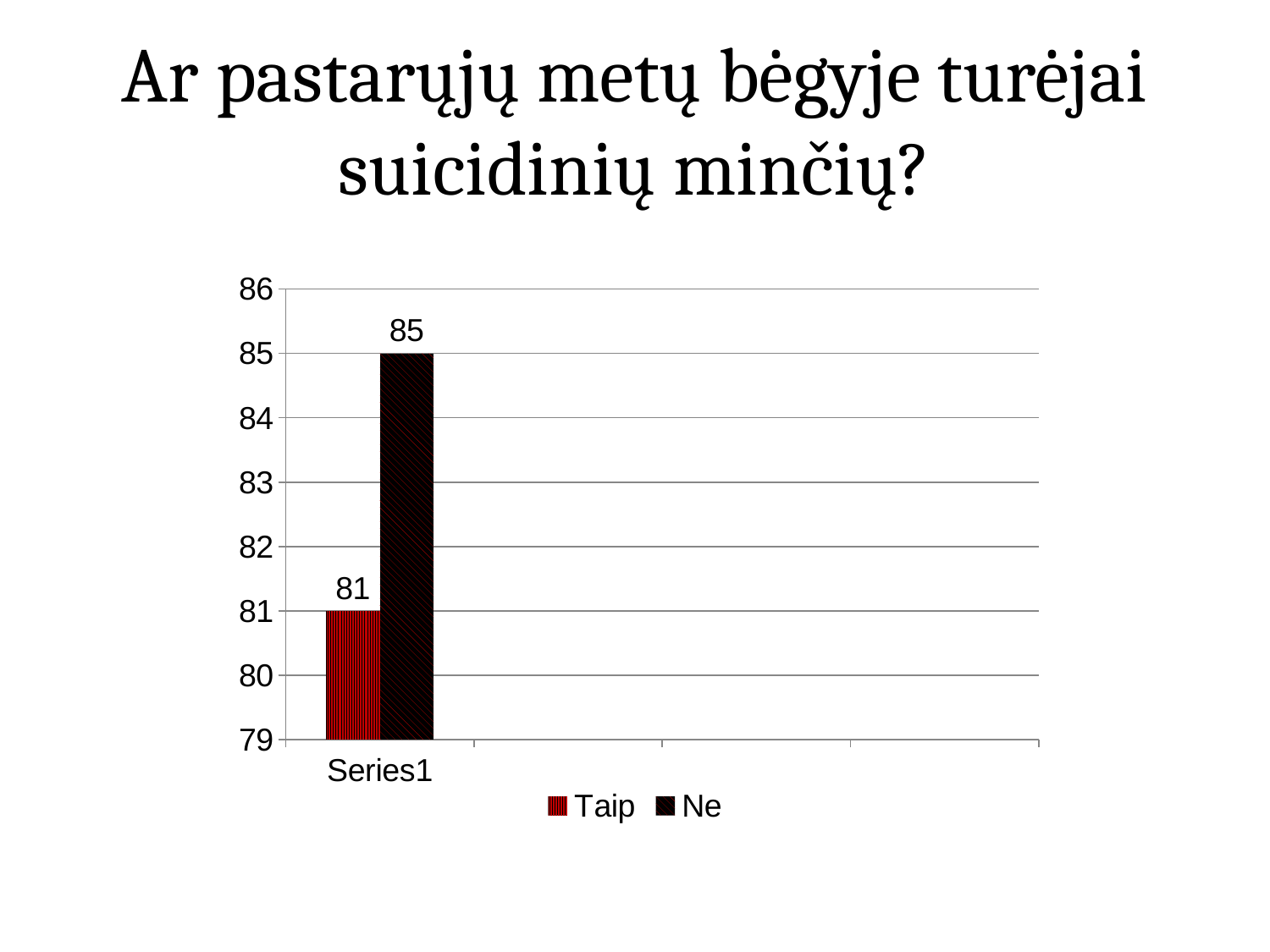
What is the highest value shown on the y axis? 86 What is the value for Ne? 85 Which series has the higher value, Taip or Ne? Ne Is the value for Ne greater or less than 84? greater What is the value for Taip? 81 What is the category label shown on the x axis? Series1 Is the value for Taip greater or less than 83? less What is the title of the slide containing the chart? Ar pastarųjų metų bėgyje turėjai suicidinių minčių? What kind of chart is shown on the slide? bar chart What is the difference between the values for Ne and Taip? 4 Which series has the lowest value? Taip How many series does the legend list? 2